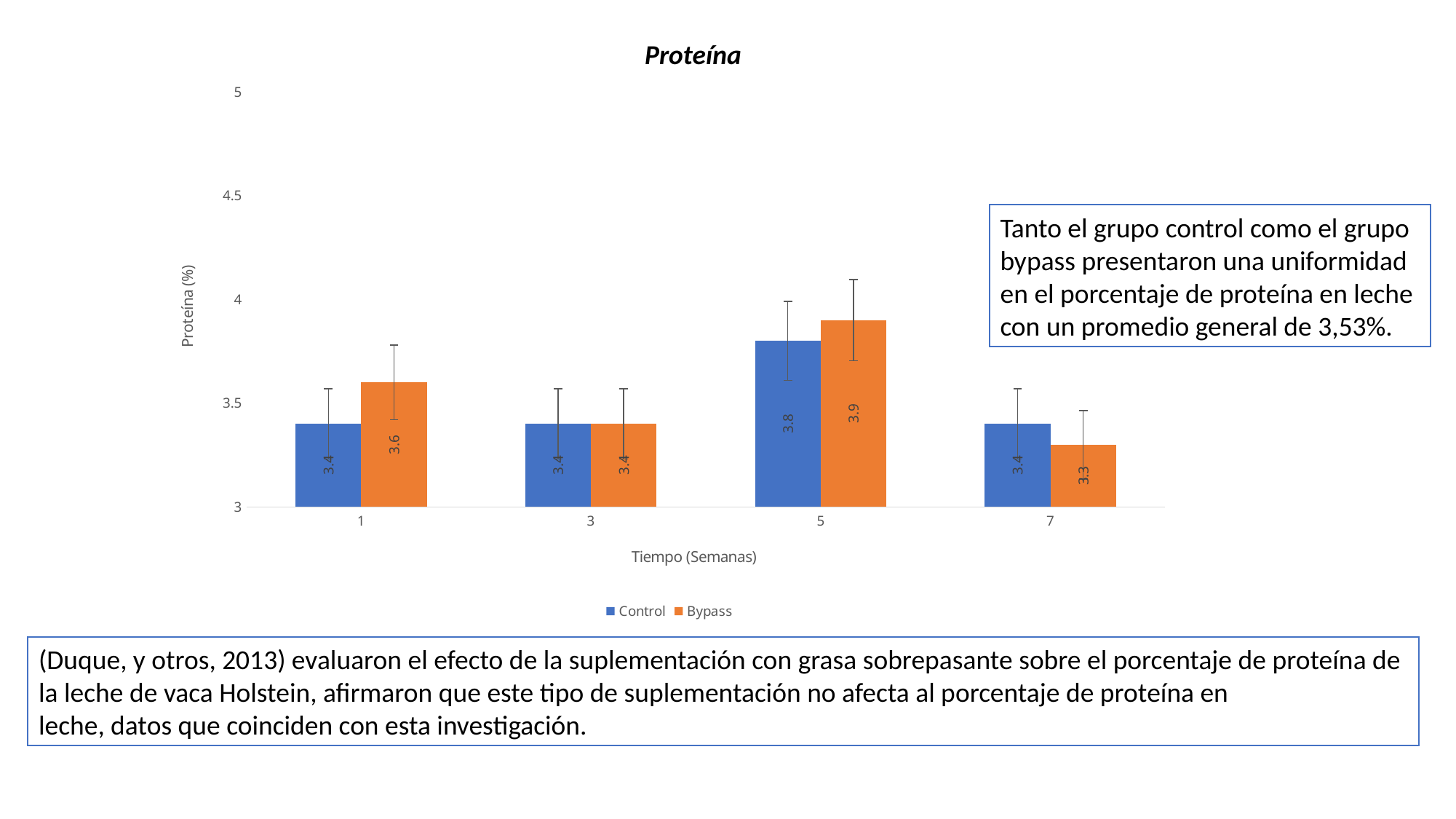
At which week is the Bypass value lowest? 7 How many series does the legend list? 2 What is the Control value at week 5? 3.8 What is the Bypass value at week 7? 3.3 What is the Control value at week 1? 3.4 At which week is the Bypass value highest? 5 How many weeks (categories) are shown on the x axis? 4 Is the Control value at week 5 greater or less than 3.5? greater What is the Bypass value at week 5? 3.9 What is the difference between the Bypass and Control values at week 1? 0.2 What type of chart is shown? Bar chart Which is larger at week 7, the Control value or the Bypass value? Control